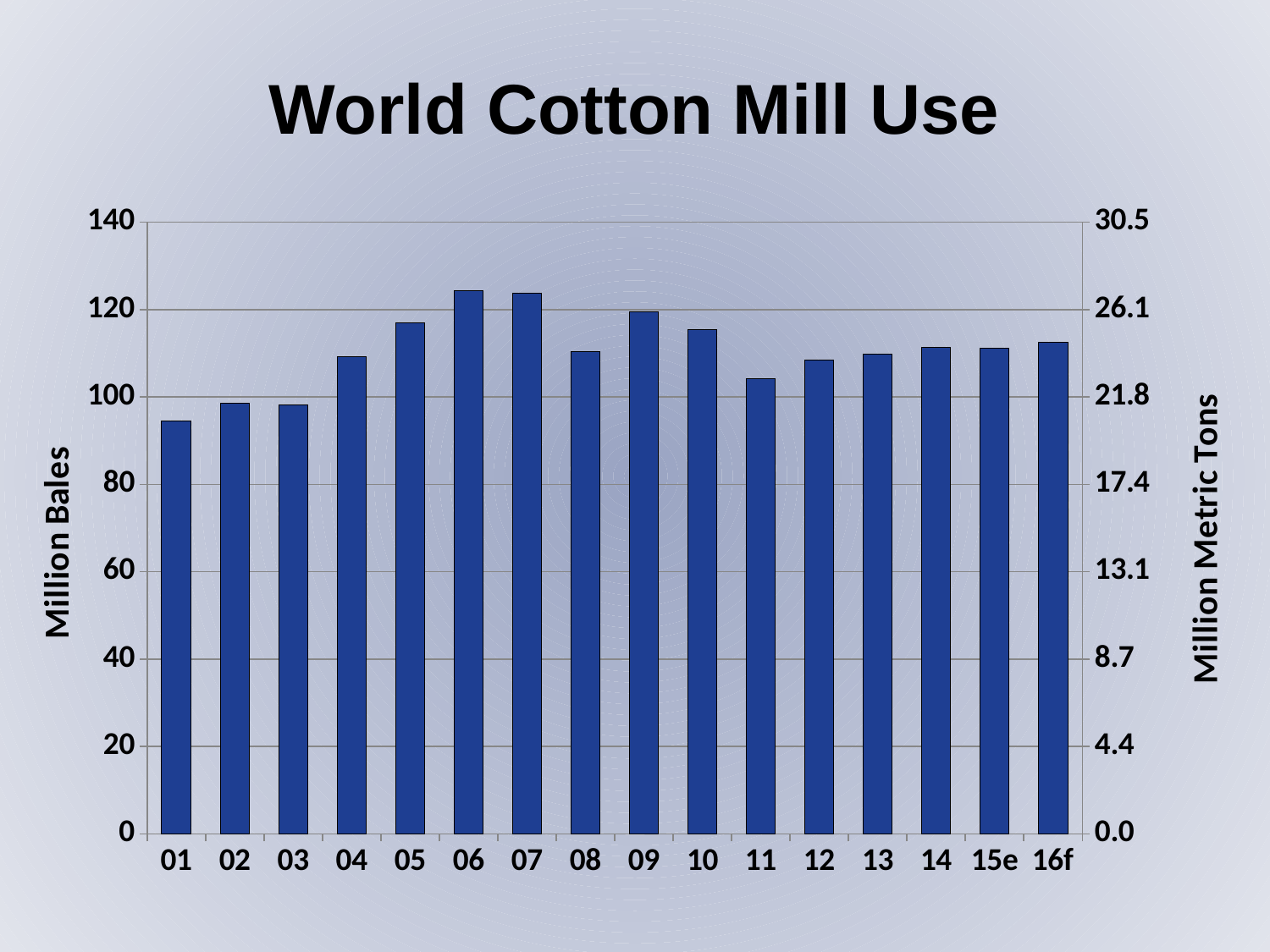
Is the value for 11 greater or less than 100 million bales? greater Is the value for 06 greater or less than 120 million bales? greater Do the values rise or fall from 01 to 06? rise What is the title of the chart? World Cotton Mill Use Which year has the larger value, 08 or 09? 09 Is the value for 05 greater or less than 120 million bales? less How many years (categories) are plotted on the x axis? 16 Which year has the lowest world cotton mill use? 01 What is the label of the right-hand vertical axis? Million Metric Tons Which year has the larger value, 05 or 11? 05 What kind of chart is shown on the slide? bar chart